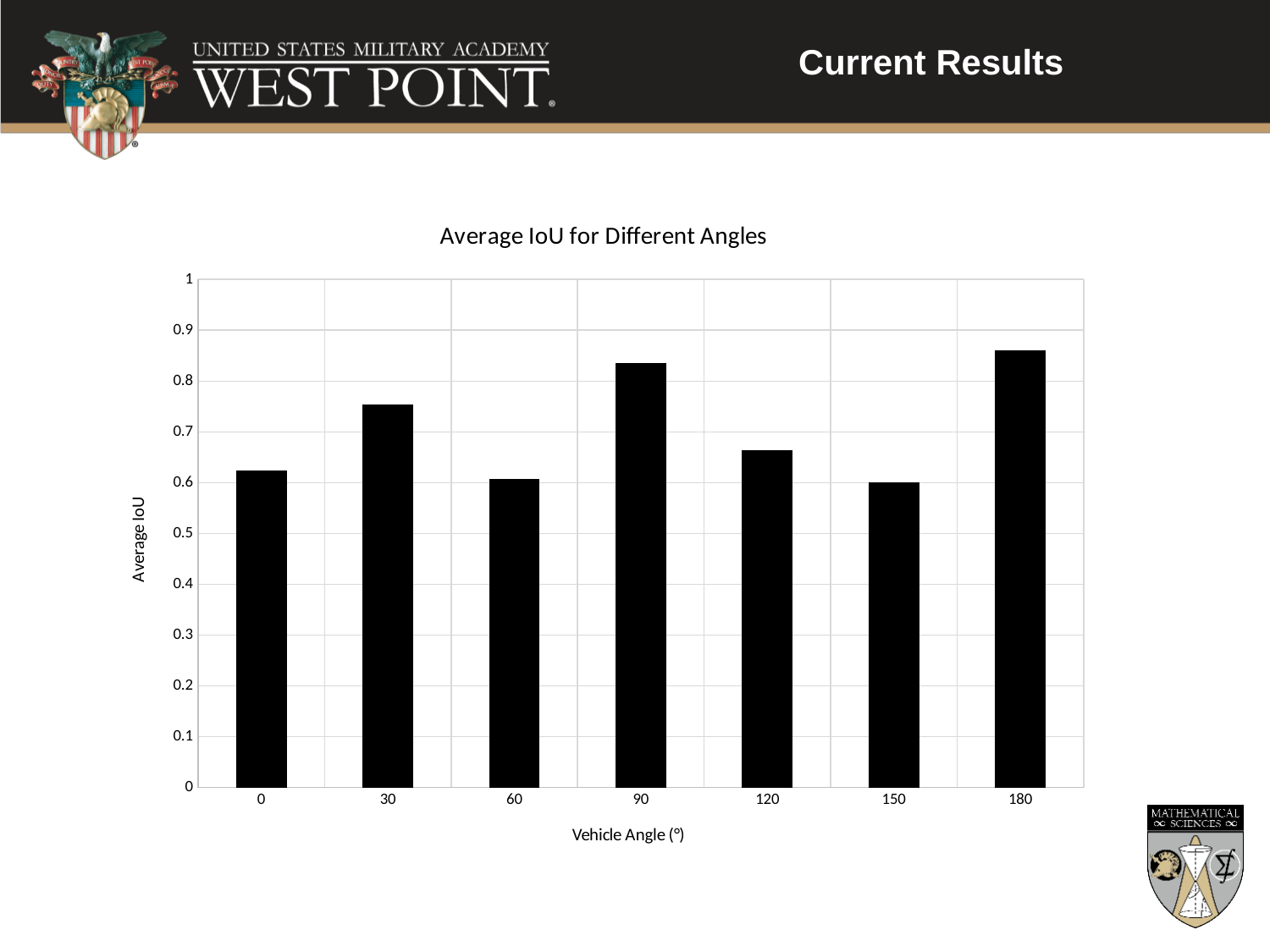
What is the title of the chart? Average IoU for Different Angles Is the average IoU for a vehicle angle of 120 greater or less than 0.7? less Is the average IoU for a vehicle angle of 150 greater or less than 0.7? less Which has a higher average IoU, a vehicle angle of 0 or 30? 30 What type of chart is shown on the slide? bar chart Is the average IoU for a vehicle angle of 30 greater or less than 0.7? greater Which vehicle angle has the highest average IoU? 180 How many vehicle angle categories are plotted in the chart? 7 Which has a higher average IoU, a vehicle angle of 90 or 120? 90 What is the label of the x axis? Vehicle Angle (°)